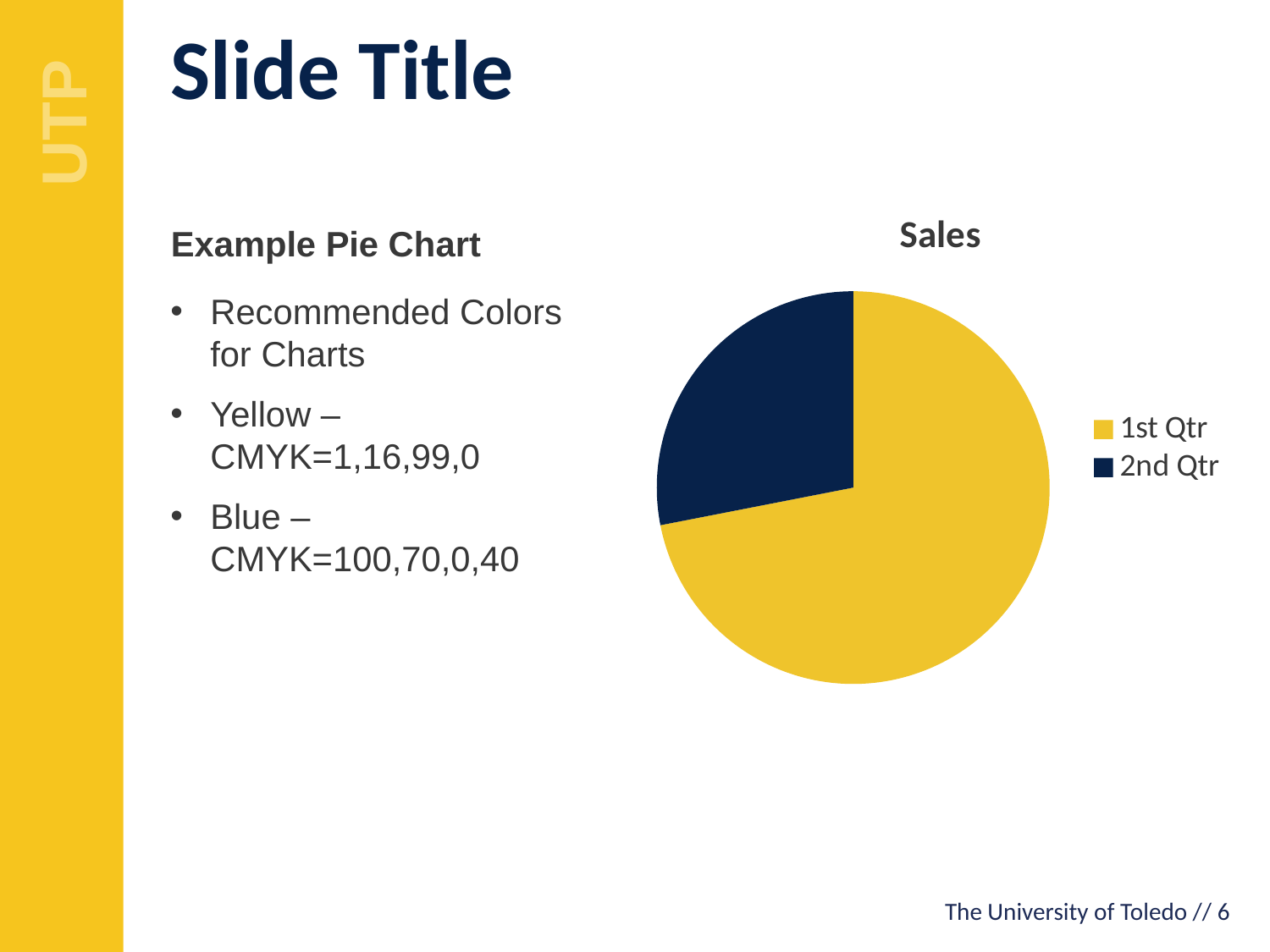
How many entries does the chart legend list? 2 What is the title of the chart? Sales Which slice of the pie chart is the largest? 1st Qtr What colour is the 1st Qtr slice in the pie chart? yellow What type of chart is shown on the slide? pie chart How many slices does the pie chart have? 2 Which slice of the pie chart is the smallest? 2nd Qtr Which is larger in the pie chart, 1st Qtr or 2nd Qtr? 1st Qtr